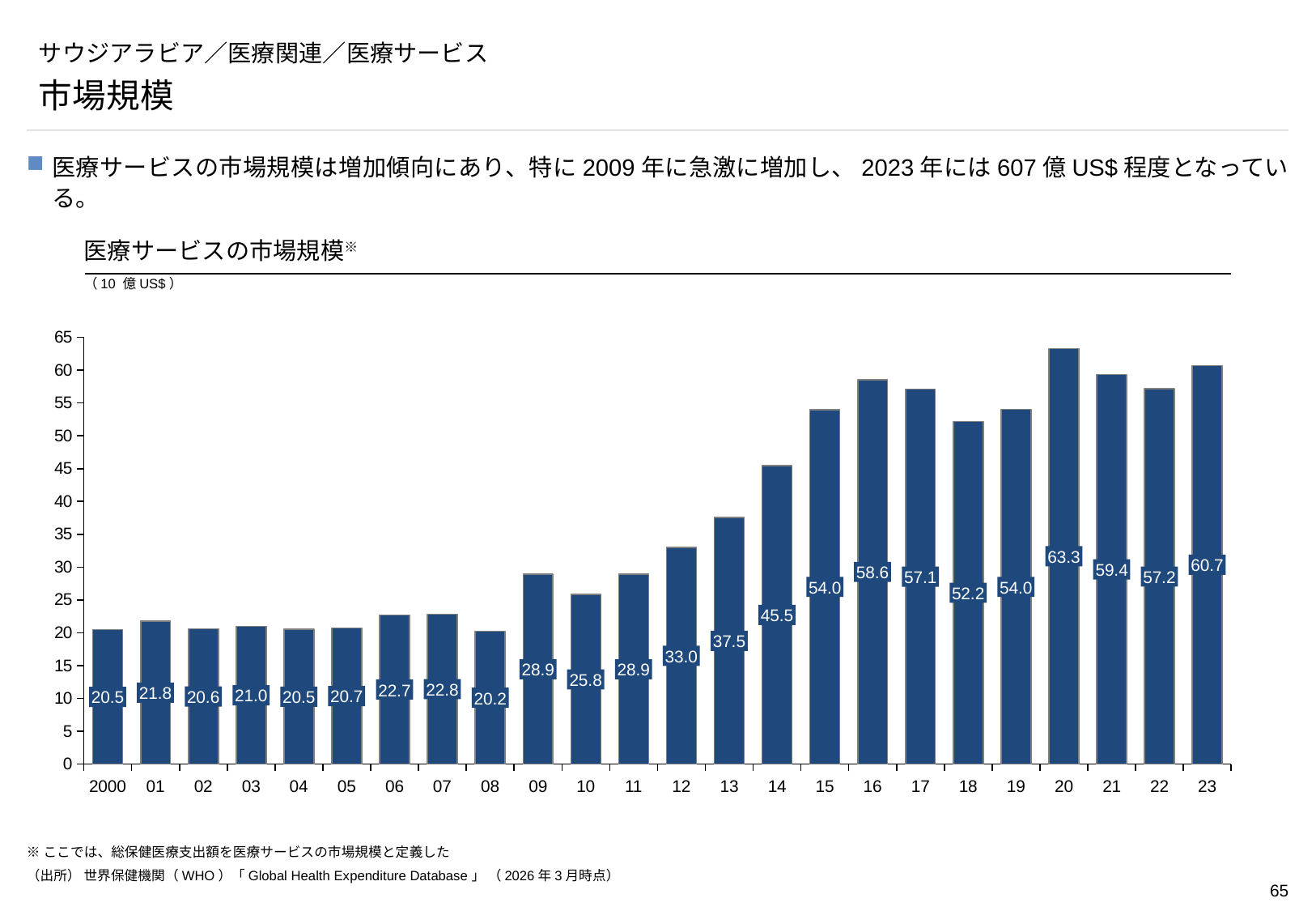
What unit is shown for the chart values? 10 億 US$ What is the value for 2009? 28.9 Do the values generally rise or fall from 2008 to 2016? rise Which is larger, the value for 2016 or the value for 2017? 2016 Is the value for 2014 greater or less than 40? greater What is the value for 2000? 20.5 What is the value for 2023? 60.7 What is the difference between the values for 2020 and 2023? 2.6 Which year has the highest value? 20 What kind of chart is this? bar chart Which year has the lowest value? 08 How many years are shown on the x axis? 24